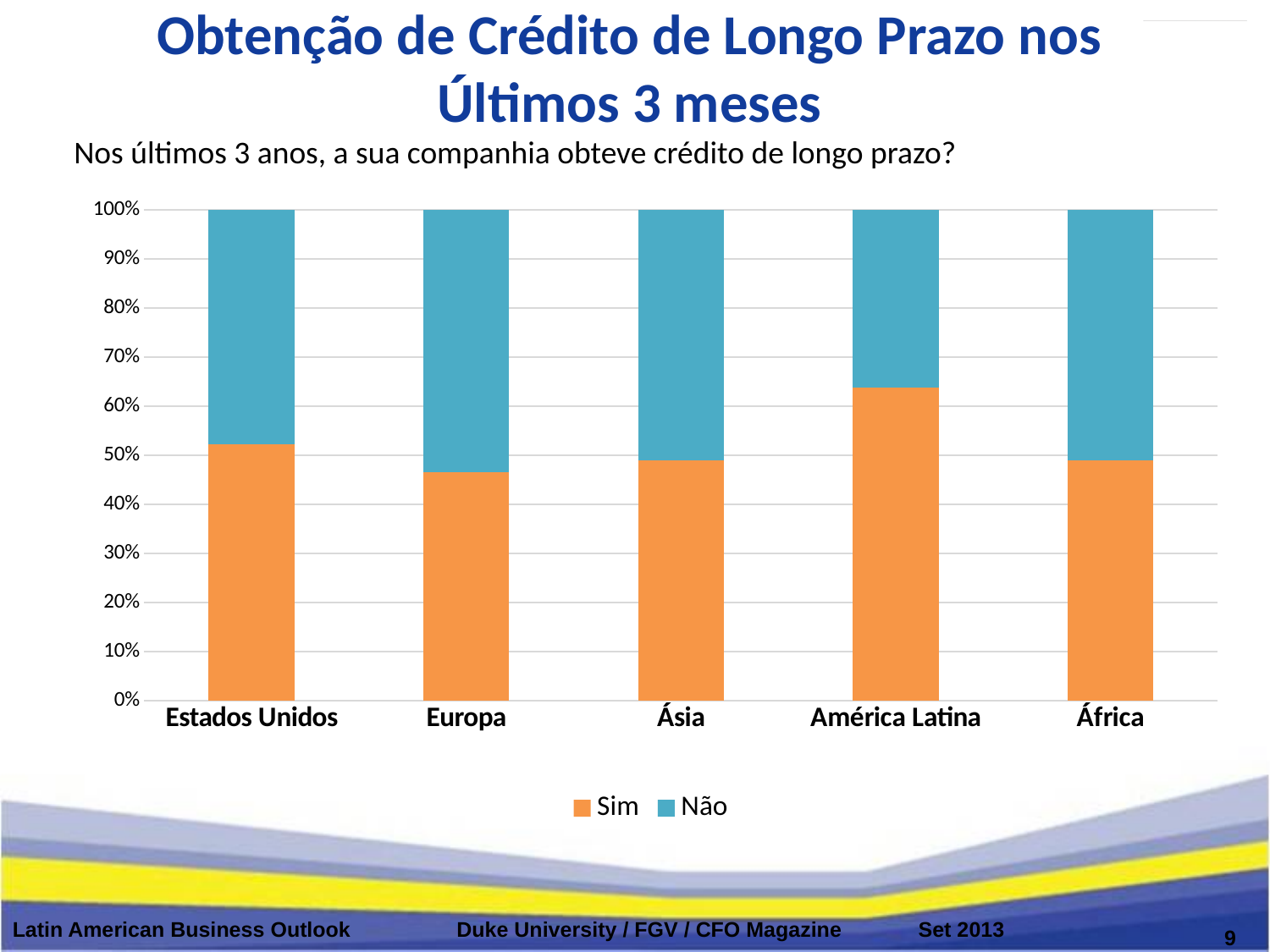
Which has a larger 'Sim' share, América Latina or Europa? América Latina Is the 'Não' share for América Latina greater or less than 40%? less Which has a larger 'Sim' share, Estados Unidos or Europa? Estados Unidos What are the two entries in the chart legend? Sim and Não Which has a larger 'Não' share, Europa or América Latina? Europa Is the 'Sim' value for Europa greater or less than 50%? less What kind of chart is shown on the slide? Stacked bar chart How many regions are shown on the x axis of the chart? 5 How many series does the chart legend list? 2 Is the 'Sim' value for América Latina greater or less than 60%? greater Which region has the highest share of 'Sim' responses? América Latina